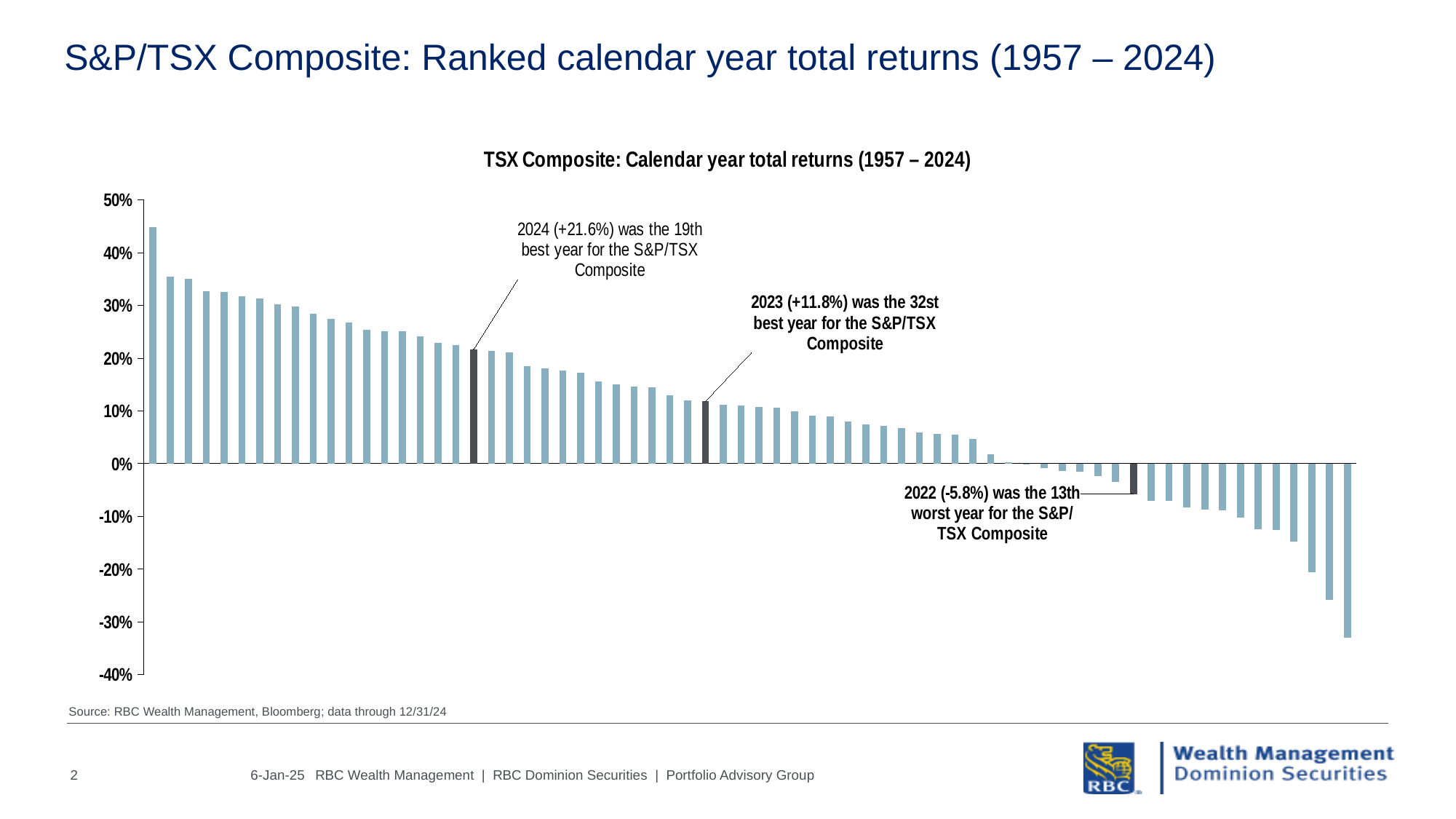
What was the S&P/TSX Composite total return for 2022 according to the chart annotation? -5.8% What was the S&P/TSX Composite total return for 2023 according to the chart annotation? +11.8% What kind of chart is shown on the slide? Bar chart What is the difference between the 2023 return and the 2022 return? 17.6 percentage points What was the S&P/TSX Composite total return for 2024 according to the chart annotation? +21.6% What is the title of the chart? TSX Composite: Calendar year total returns (1957 – 2024) By how many percentage points did the 2024 return exceed the 2023 return? 9.8 percentage points Which year had the higher total return, 2024 or 2023? 2024 According to the annotation, what rank was 2022 among the worst years for the S&P/TSX Composite? 13th worst Is the value of the tallest bar in the chart greater or less than 40%? greater Do the bar values rise or fall moving from left to right across the chart? Fall Is the value of the lowest bar in the chart greater or less than -30%? less